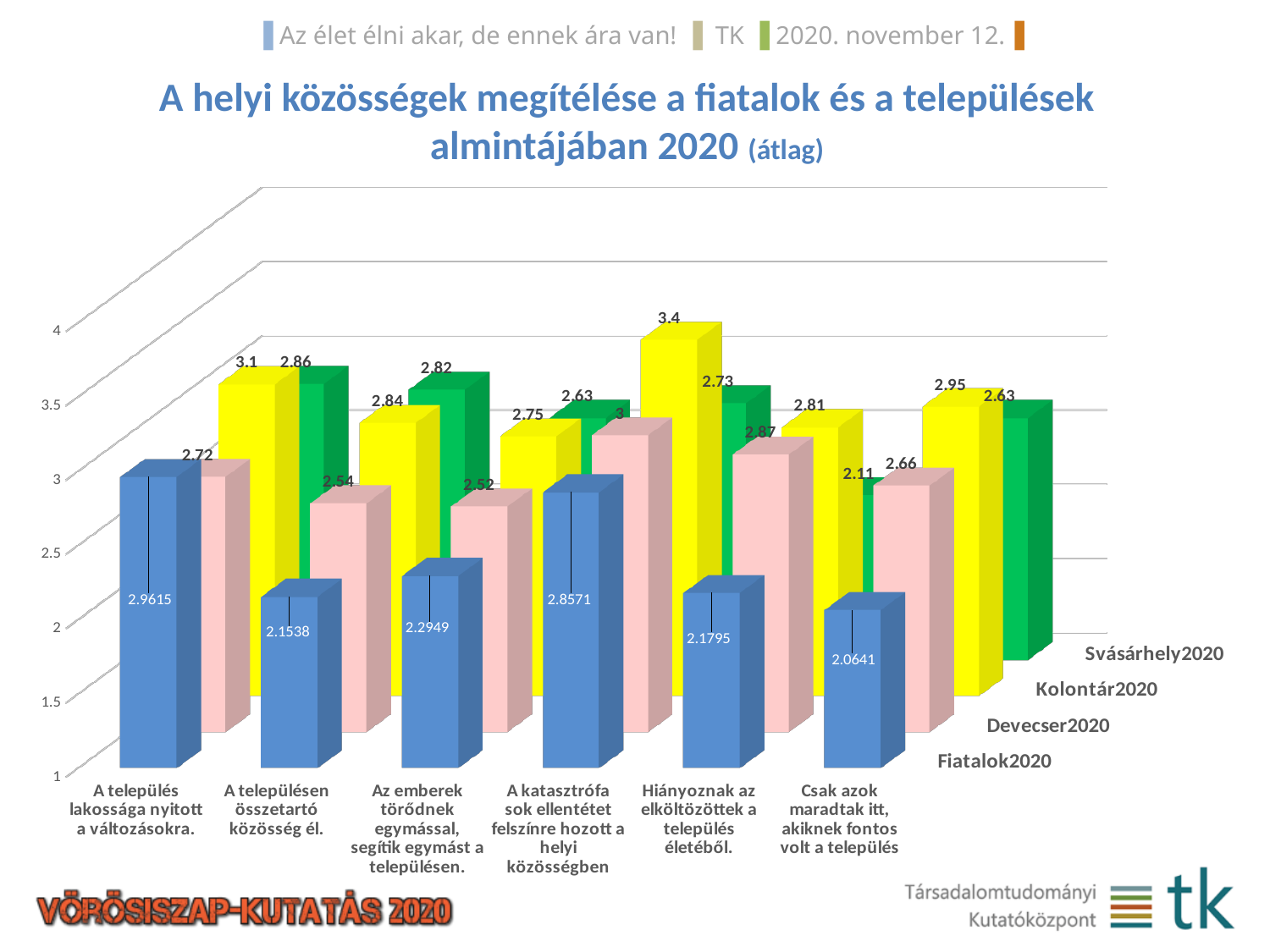
In the category "A település lakossága nyitott a változásokra.", which series has the larger value: Fiatalok2020 or Devecser2020? Fiatalok2020 What kind of chart is shown on the slide? Bar chart What is the value for Kolontár2020 in the category "A katasztrófa sok ellentétet felszínre hozott a helyi közösségben"? 3.4 What is the value for Fiatalok2020 in the category "Csak azok maradtak itt, akiknek fontos volt a település"? 2.0641 In which category does Fiatalok2020 have its lowest value? Csak azok maradtak itt, akiknek fontos volt a település How many series does the chart show? 4 In the category "A katasztrófa sok ellentétet felszínre hozott a helyi közösségben", what is the difference between the Kolontár2020 value and the Devecser2020 value? 0.4 What is the value for Fiatalok2020 in the category "A település lakossága nyitott a változásokra."? 2.9615 What is the value for Svásárhely2020 in the category "A településen összetartó közösség él."? 2.82 In which category does Kolontár2020 have its highest value? A katasztrófa sok ellentétet felszínre hozott a helyi közösségben How many categories are shown on the x axis of the chart? 6 What is the value for Devecser2020 in the category "Hiányoznak az elköltözöttek a település életéből."? 2.87